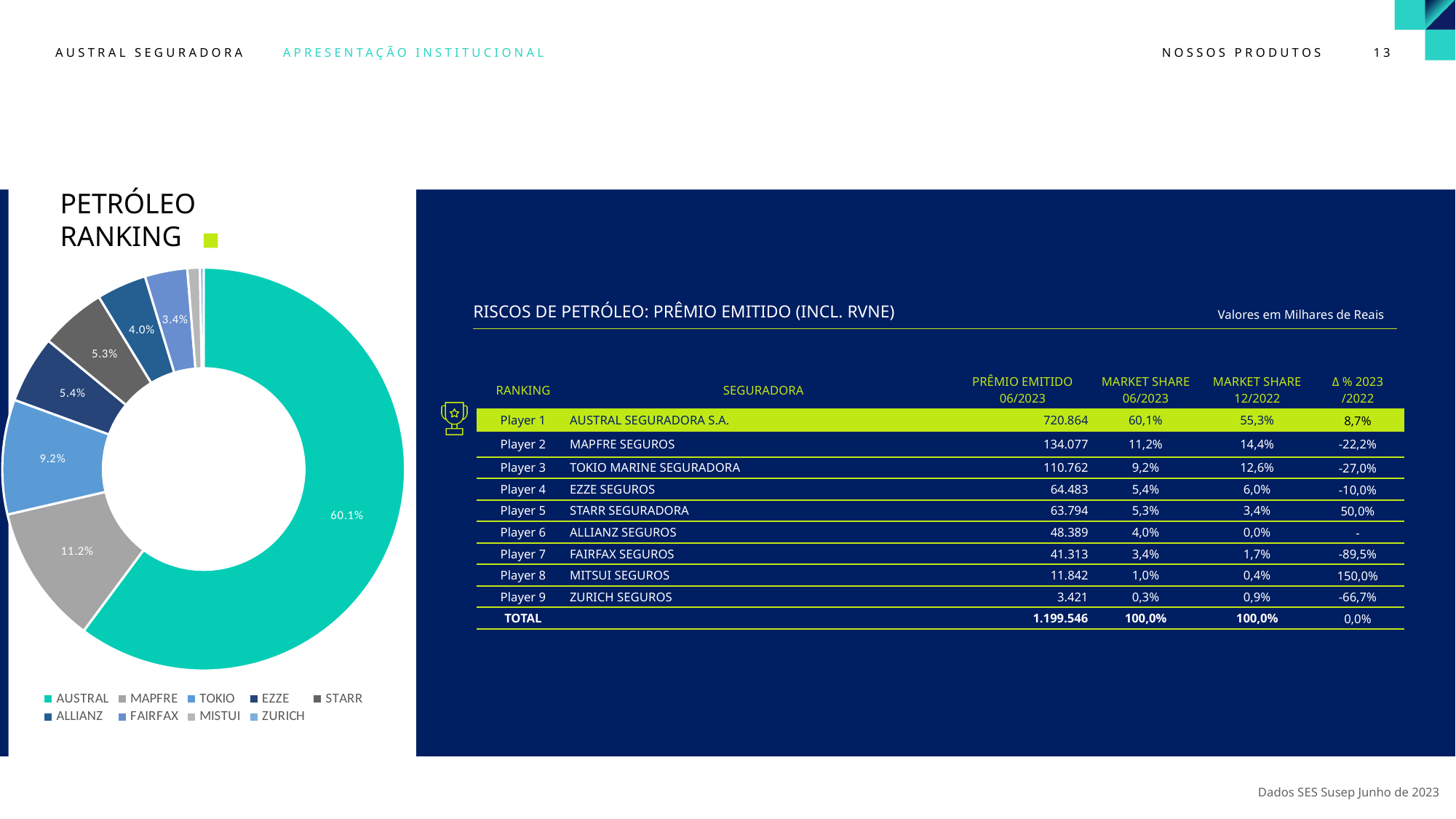
In the PETRÓLEO RANKING chart, what share does FAIRFAX hold? 3.4% In the PETRÓLEO RANKING chart, what is the difference in percentage points between AUSTRAL's share and MAPFRE's share? 48.9 percentage points In the PETRÓLEO RANKING chart, what colour is the AUSTRAL slice? teal In the PETRÓLEO RANKING chart, what share does MAPFRE hold? 11.2% In the PETRÓLEO RANKING chart, what share does TOKIO hold? 9.2% What kind of chart is shown on the left of the slide? donut chart In the PETRÓLEO RANKING chart, which company has the largest slice? AUSTRAL In the PETRÓLEO RANKING chart, what share does AUSTRAL hold? 60.1% In the PETRÓLEO RANKING chart, what share does ALLIANZ hold? 4.0% In the PETRÓLEO RANKING chart, which slice is larger, MAPFRE or TOKIO? MAPFRE How many companies are listed in the legend of the PETRÓLEO RANKING chart? 9 What is the title of the donut chart on the slide? PETRÓLEO RANKING